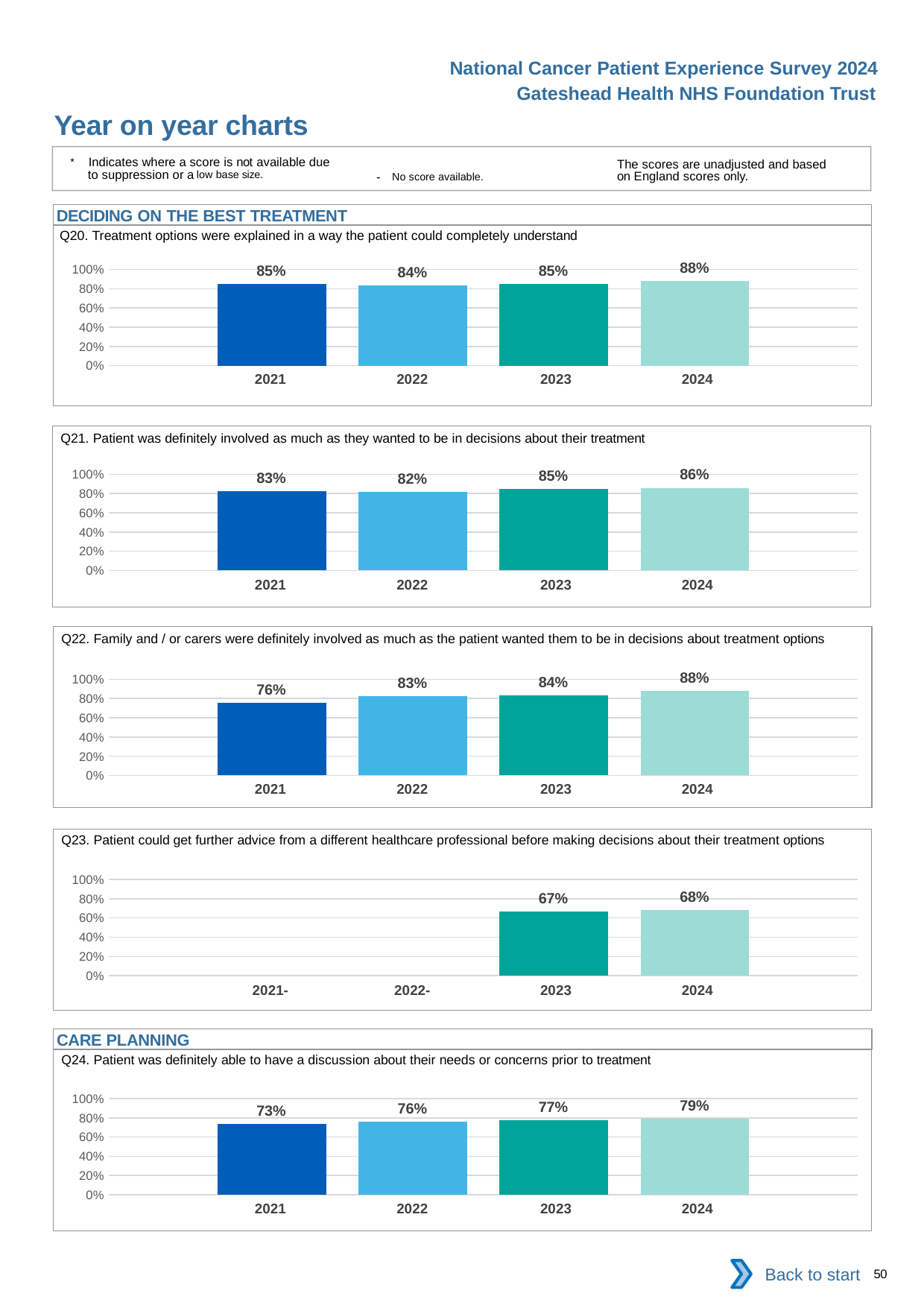
In the Q24 chart, which is larger, the value for 2023 or the value for 2024? 2024 In the Q20 chart, which year has the lowest value? 2022 In the Q22 chart, what is the difference between the 2022 value and the 2021 value? 7 percentage points In the Q22 chart (Family and / or carers were definitely involved as much as the patient wanted them to be in decisions about treatment options), which year has the highest value? 2024 In the Q20 chart (Treatment options were explained in a way the patient could completely understand), what is the value for 2024? 88% In the Q21 chart (Patient was definitely involved as much as they wanted to be in decisions about their treatment), what is the value for 2022? 82% In the Q23 chart (Patient could get further advice from a different healthcare professional before making decisions about their treatment options), what is the value for 2023? 67% In the Q23 chart, how many years have a bar plotted? 2 In the Q22 chart, do the values rise or fall from 2021 to 2024? rise In the Q24 chart (Patient was definitely able to have a discussion about their needs or concerns prior to treatment), what is the value for 2021? 73% In the Q21 chart, what is the difference between the 2024 value and the 2021 value? 3 percentage points What kind of chart is the Q24 chart? bar chart